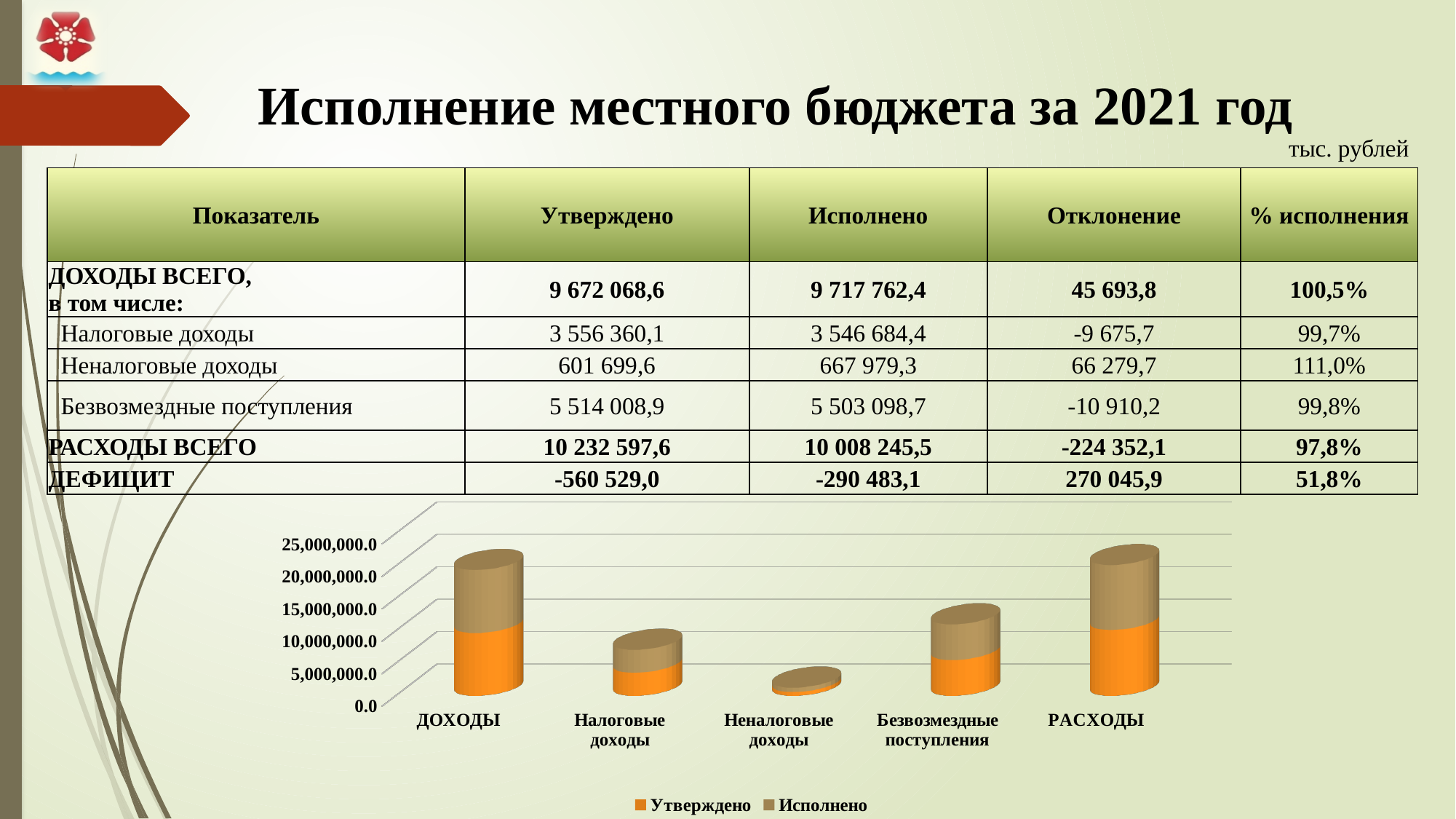
Which series is shown in orange in the chart? Утверждено Is the total stacked value for ДОХОДЫ greater or less than 15,000,000.0? greater Which category has the lowest stacked bar in the chart? Неналоговые доходы What kind of chart is shown on the slide? bar chart How many categories are shown on the x axis of the chart? 5 How many series does the chart legend list? 2 Among Налоговые доходы, Неналоговые доходы and Безвозмездные поступления, which has the tallest stacked bar? Безвозмездные поступления Is the total stacked value for РАСХОДЫ greater or less than 15,000,000.0? greater What is the highest value labelled on the chart's vertical axis? 25,000,000.0 Is the stacked bar for Безвозмездные поступления taller or shorter than the one for Налоговые доходы? taller Is the total stacked value for Неналоговые доходы greater or less than 5,000,000.0? less